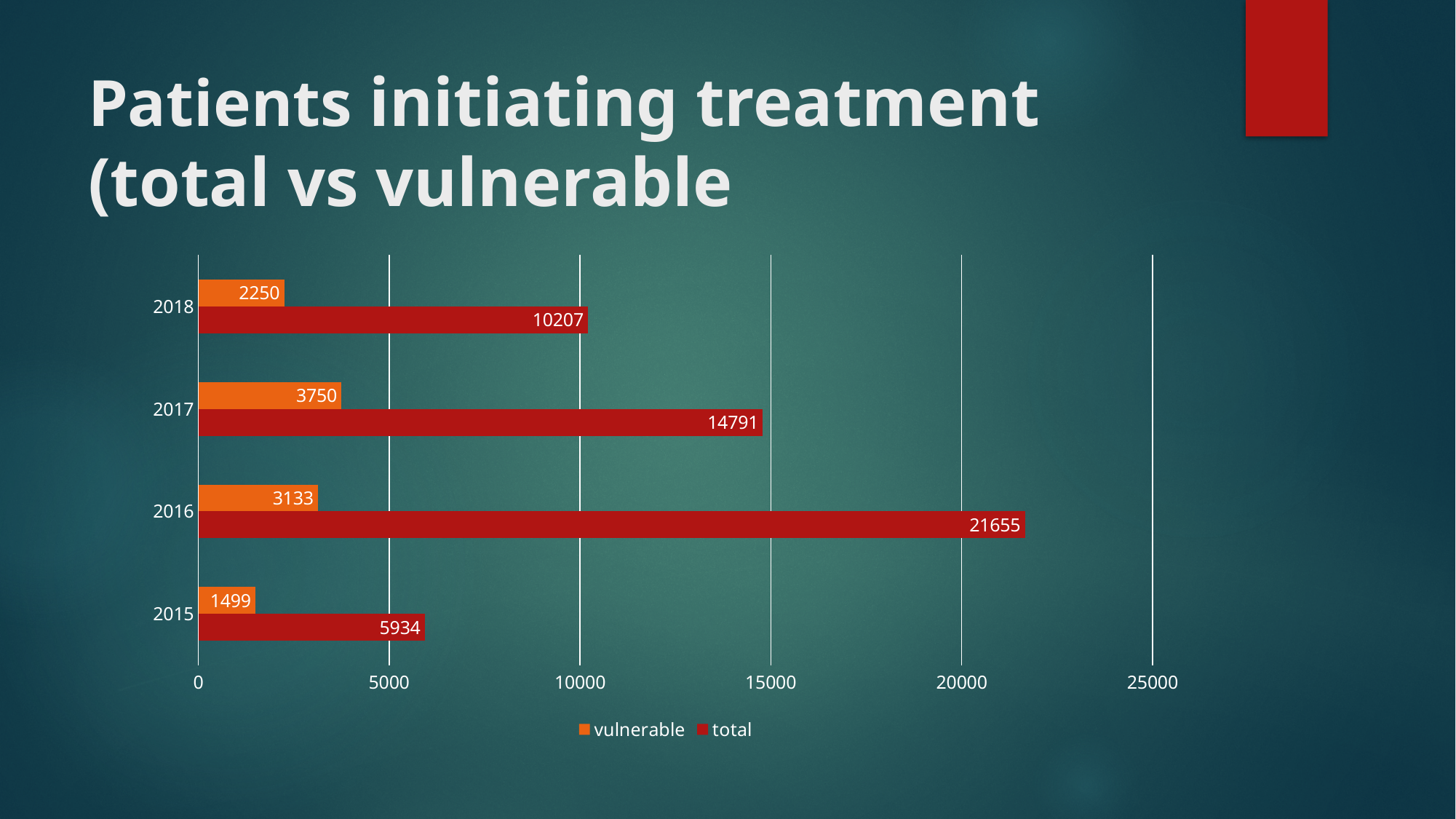
Which is larger, the vulnerable value for 2016 or the vulnerable value for 2017? 2017 What is the vulnerable value for 2017? 3750 What is the difference between the total and vulnerable values for 2018? 7957 How many series does the legend list? 2 What is the total number of patients initiating treatment in 2016? 21655 Is the total value for 2017 greater or less than 15000? less How many years are shown on the chart? 4 Which year has the highest total value? 2016 What is the total value for 2015? 5934 Which year has the lowest vulnerable value? 2015 Which colour represents the vulnerable series? orange What kind of chart is shown on the slide? bar chart